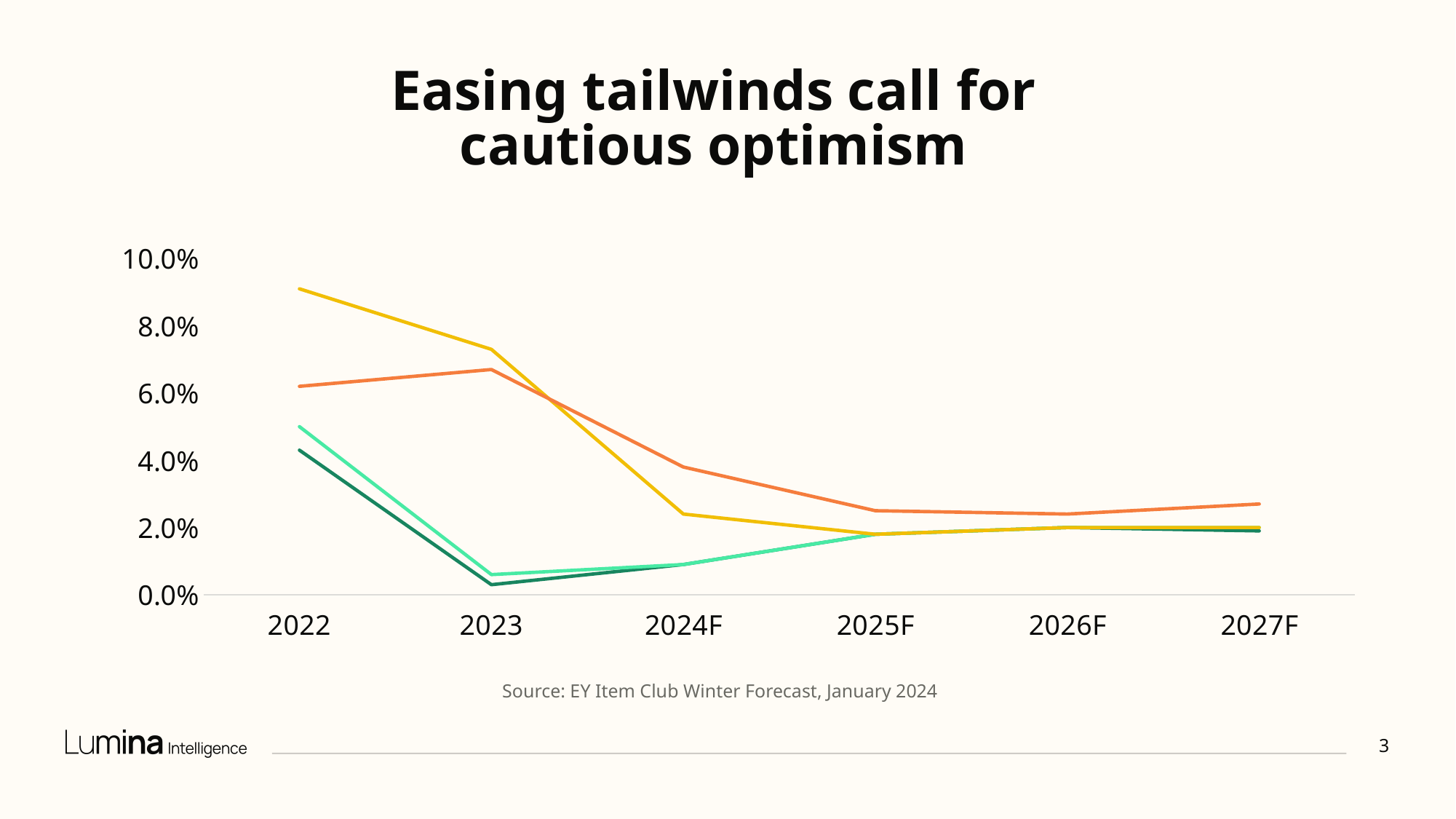
Does the light green line rise or fall from 2023 to 2027F? rise Is the value of the dark green line in 2023 greater or less than 2.0%? less Is the value of the orange line in 2023 greater or less than 6.0%? greater Is the value of the yellow line in 2022 greater or less than 8.0%? greater Does the yellow line rise or fall from 2022 to 2025F? fall Which line has the highest value in 2022? the yellow line What is the title of the slide containing the chart? Easing tailwinds call for cautious optimism Which line has the lowest value in 2023? the dark green line What kind of chart is shown on the slide? line chart How many points are labelled along the x axis of the chart? 6